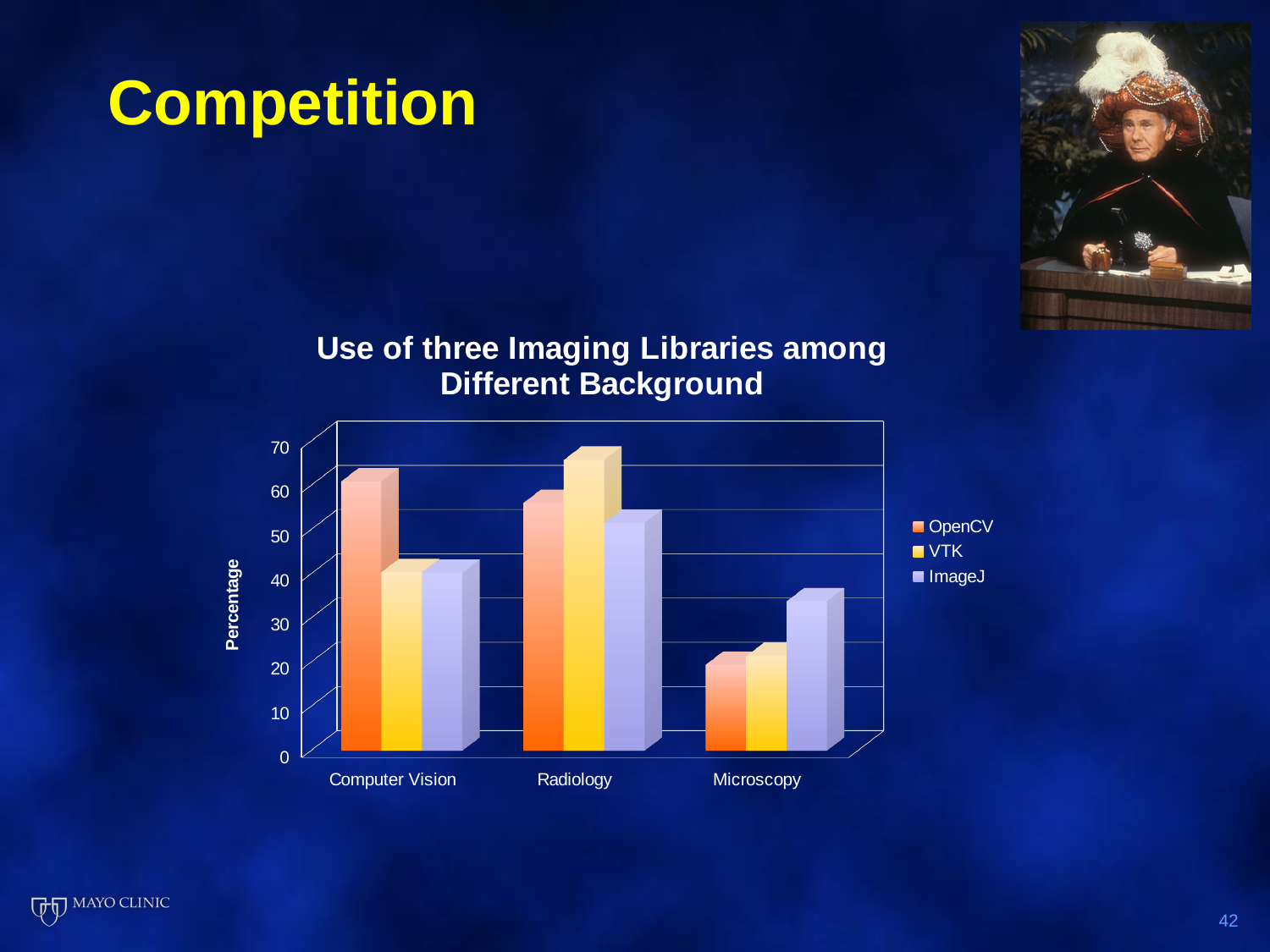
Which library has the highest value in the Microscopy category? ImageJ Which library has the highest value in the Computer Vision category? OpenCV Is the value for OpenCV in Computer Vision greater or less than 50? greater What is the title of the chart? Use of three Imaging Libraries among Different Background What is the label of the vertical axis? Percentage Is the value for VTK in Computer Vision greater or less than 50? less In which category is the OpenCV value lowest? Microscopy What kind of chart is shown on the slide? bar chart How many series does the legend list? 3 Which is larger: the VTK value for Radiology or the VTK value for Computer Vision? Radiology How many categories are shown on the x axis? 3 Which library has the highest value in the Radiology category? VTK